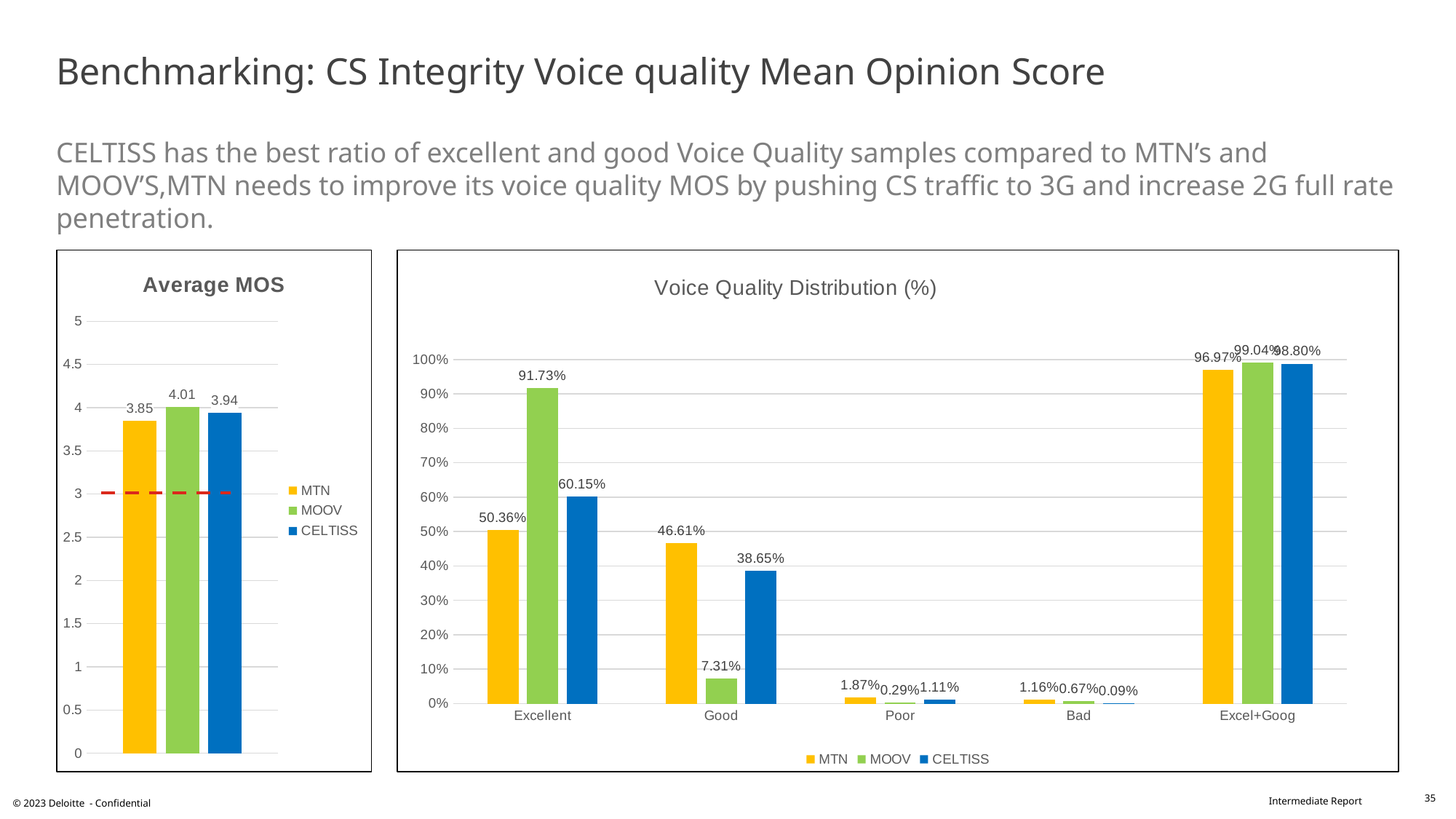
What kind of chart is the Voice Quality Distribution (%) chart? Bar chart In the Voice Quality Distribution (%) chart, what is the value for CELTISS in the Good category? 38.65% In the Voice Quality Distribution (%) chart, is the value for MTN in the Good category larger than the value for MOOV in the Good category? Yes In the Voice Quality Distribution (%) chart, which operator has the lowest value in the Bad category? CELTISS In the Average MOS chart, what is the difference between MOOV's and MTN's values? 0.16 In the Voice Quality Distribution (%) chart, which operator has the highest value in the Excel+Goog category? MOOV In the Voice Quality Distribution (%) chart, what is the value for MOOV in the Excellent category? 91.73% In the Average MOS chart, what is the value for MOOV? 4.01 In the Voice Quality Distribution (%) chart, what is the difference between MOOV's and CELTISS's values in the Excellent category? 31.58% In the Voice Quality Distribution (%) chart, how many categories are shown on the x axis? 5 In the Average MOS chart, how many series does the legend list? 3 In the Average MOS chart, which operator has the lowest average MOS? MTN